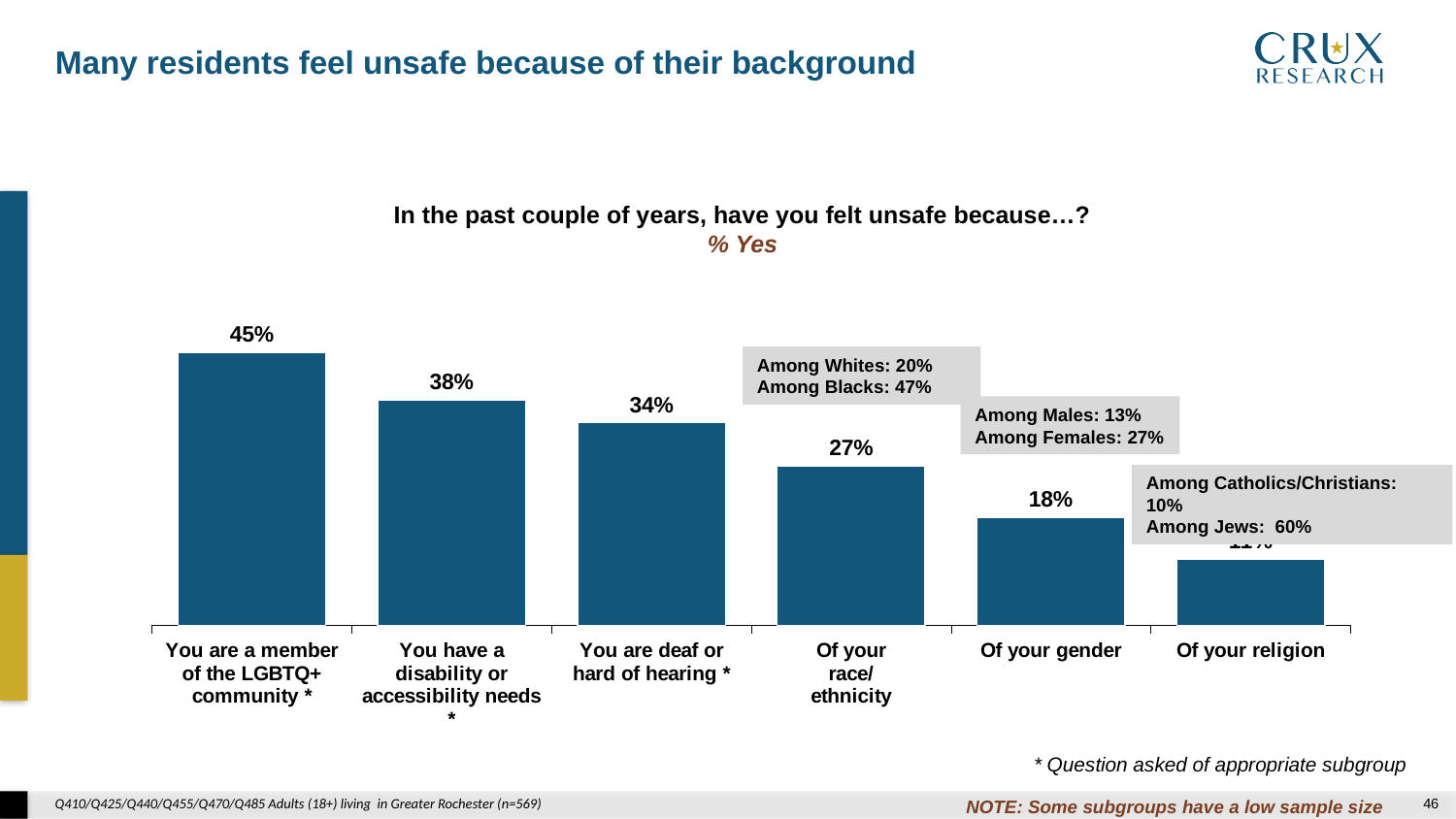
How many categories are shown in the chart? 6 What percentage of respondents said they felt unsafe because of their gender? 18% What percentage of respondents said they felt unsafe because they are deaf or hard of hearing? 34% According to the callout box, what percentage of Blacks said they felt unsafe because of their race/ethnicity? 47% Which is larger: the percentage feeling unsafe because of a disability or accessibility needs, or because of being deaf or hard of hearing? You have a disability or accessibility needs What percentage of respondents said they felt unsafe because of their race/ethnicity? 27% What type of chart is shown on the slide? Bar chart What percentage of respondents said they felt unsafe because they have a disability or accessibility needs? 38% Which category has the lowest percentage of respondents saying they felt unsafe? Of your religion What is the difference in percentage points between feeling unsafe because of being a member of the LGBTQ+ community and because of race/ethnicity? 18 percentage points What percentage of respondents said they felt unsafe because they are a member of the LGBTQ+ community? 45% Which category has the highest percentage of respondents saying they felt unsafe? You are a member of the LGBTQ+ community